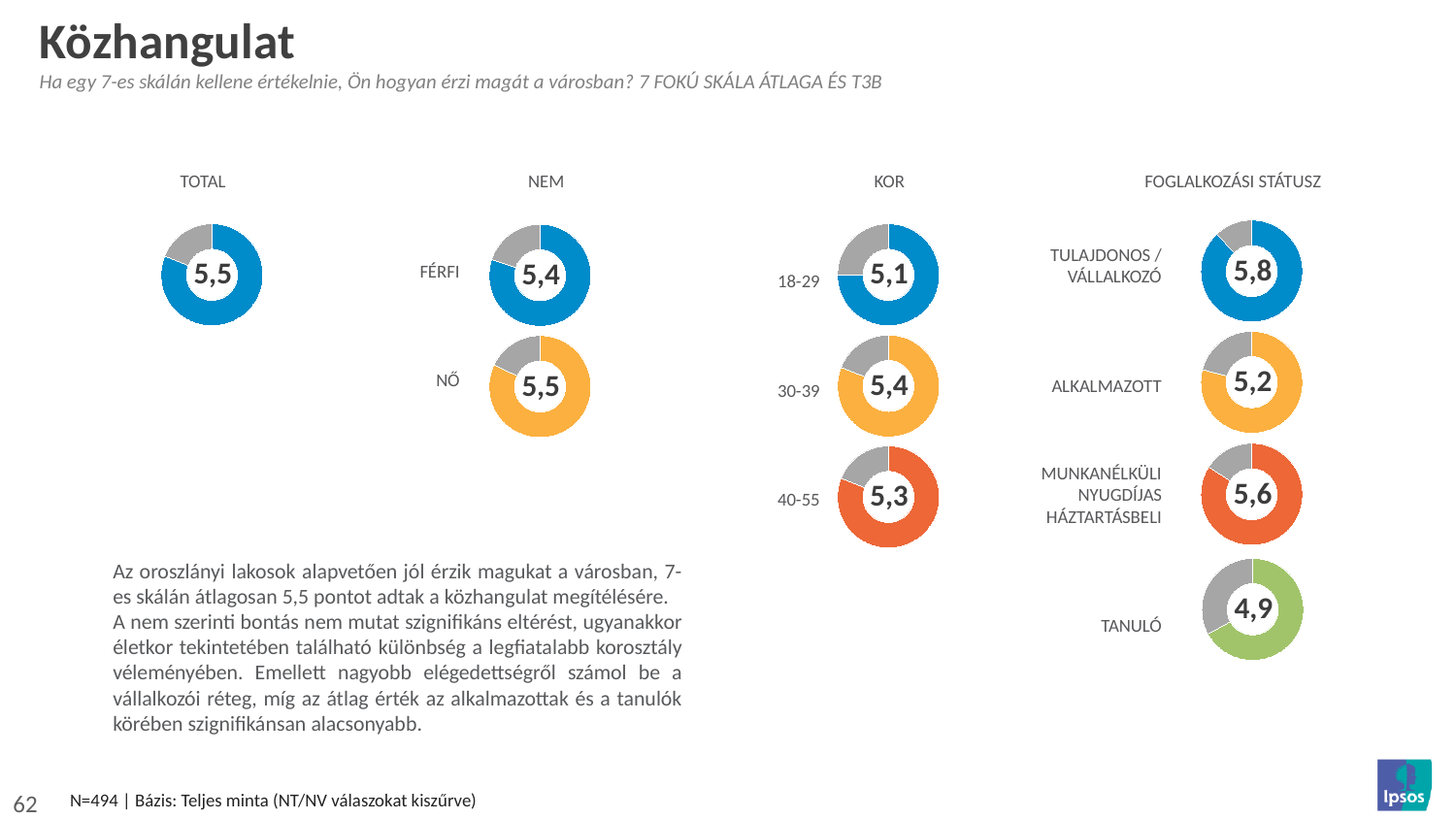
In the FOGLALKOZÁSI STÁTUSZ group of charts, which category has the highest value? TULAJDONOS / VÁLLALKOZÓ How many age groups are shown in the KOR group of charts? 3 What kind of chart is used to display the values on this slide? Donut chart In the FOGLALKOZÁSI STÁTUSZ group of charts, which is larger: the value for ALKALMAZOTT or the value for MUNKANÉLKÜLI / NYUGDÍJAS / HÁZTARTÁSBELI? MUNKANÉLKÜLI / NYUGDÍJAS / HÁZTARTÁSBELI In the KOR group of charts, what is the value for the 18-29 age group? 5,1 In the FOGLALKOZÁSI STÁTUSZ group of charts, which category has the lowest value? TANULÓ In the KOR group of charts, which age group has the lowest value? 18-29 In the NEM group of charts, what is the value for NŐ? 5,5 In the KOR group of charts, which age group has the highest value? 30-39 In the TOTAL chart, what is the average value shown? 5,5 In the NEM group of charts, what is the value for FÉRFI? 5,4 In the FOGLALKOZÁSI STÁTUSZ group of charts, what is the difference between the values for TULAJDONOS / VÁLLALKOZÓ and TANULÓ? 0,9